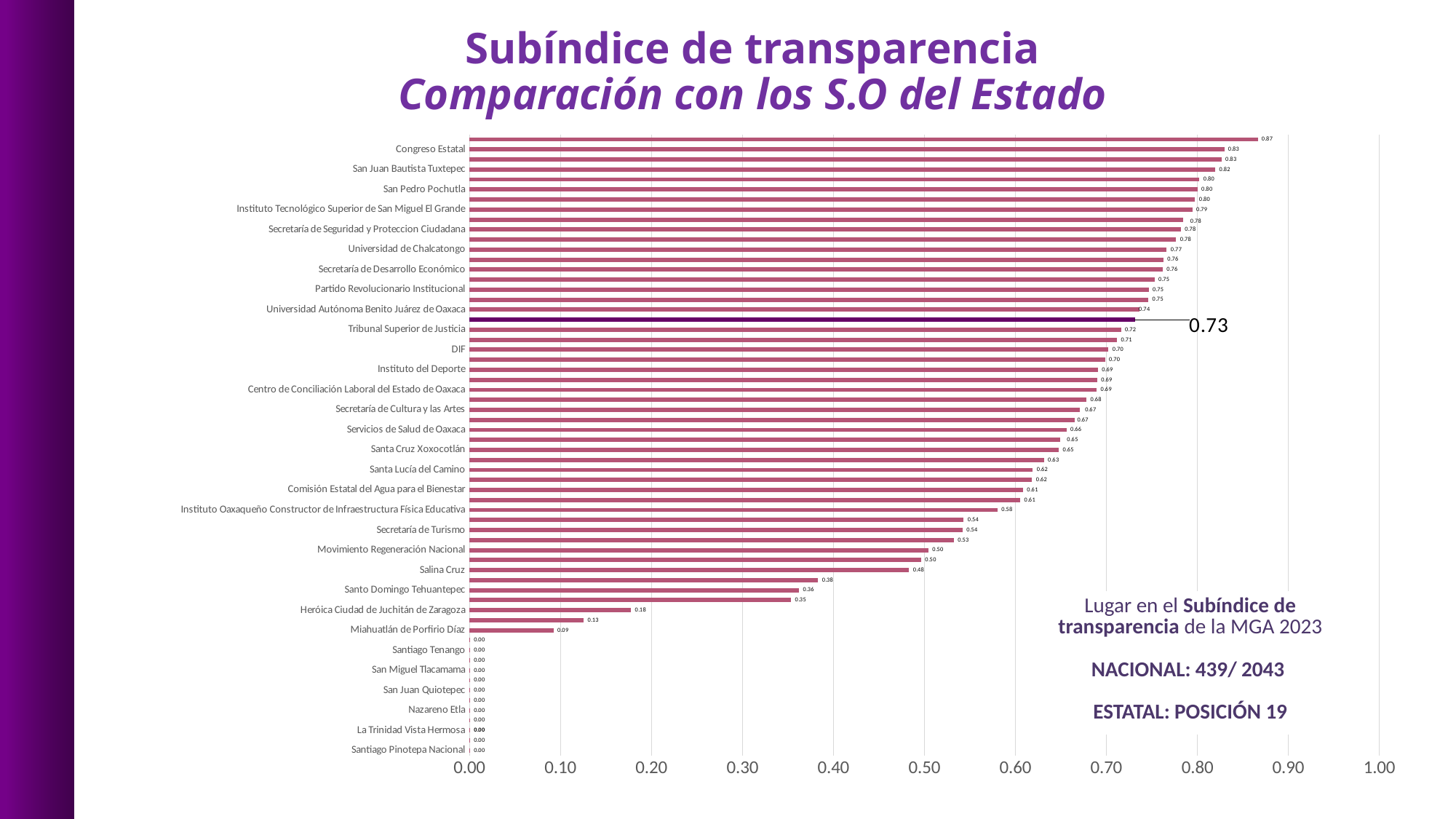
Is the value for Santo Domingo Tehuantepec greater or less than 0.40? less What is the value for Congreso Estatal? 0.83 What is the maximum value shown on the horizontal axis? 1.00 What is the highest value shown on the chart? 0.87 What is the difference between the values for Congreso Estatal and DIF? 0.13 What is the value for Santiago Tenango? 0.00 Which has a larger value, San Pedro Pochutla or Secretaría de Turismo? San Pedro Pochutla What is the value for Tribunal Superior de Justicia? 0.72 What is the value for Miahuatlán de Porfirio Díaz? 0.09 What kind of chart is shown on the slide? bar chart What is the value for Salina Cruz? 0.48 What value is labelled on the dark purple highlighted bar? 0.73